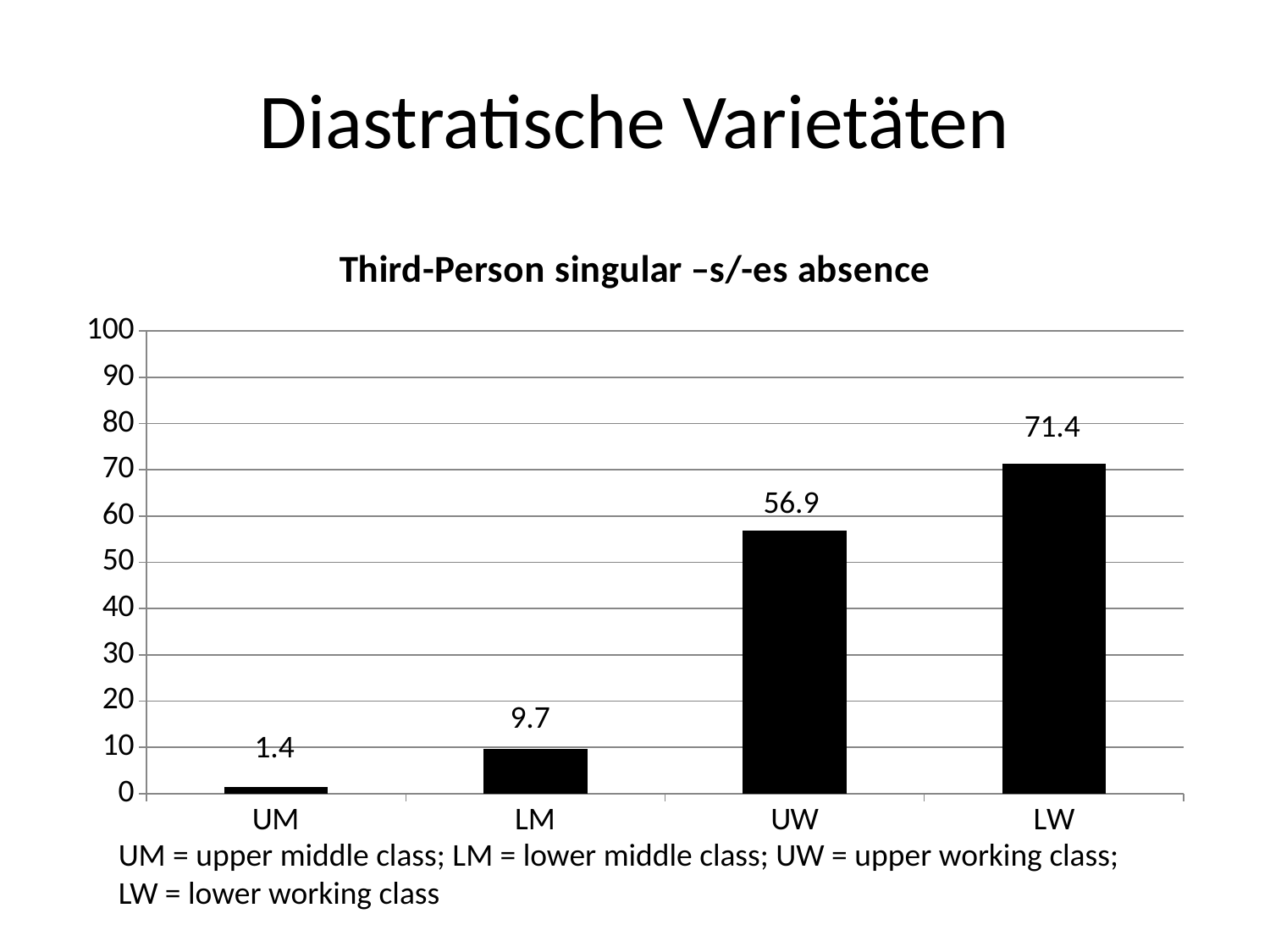
Which category has the lowest value? UM How many categories are shown on the x axis? 4 What is the value for LW? 71.4 What is the value for UM? 1.4 What kind of chart is shown? bar chart Which is larger, the value for LM or the value for UW? UW What is the difference between the values for LW and UW? 14.5 Which category has the highest value? LW Is the value for UW greater or less than 50? greater What is the value for UW? 56.9 What is the title of the chart? Third-Person singular –s/-es absence What is the value for LM? 9.7